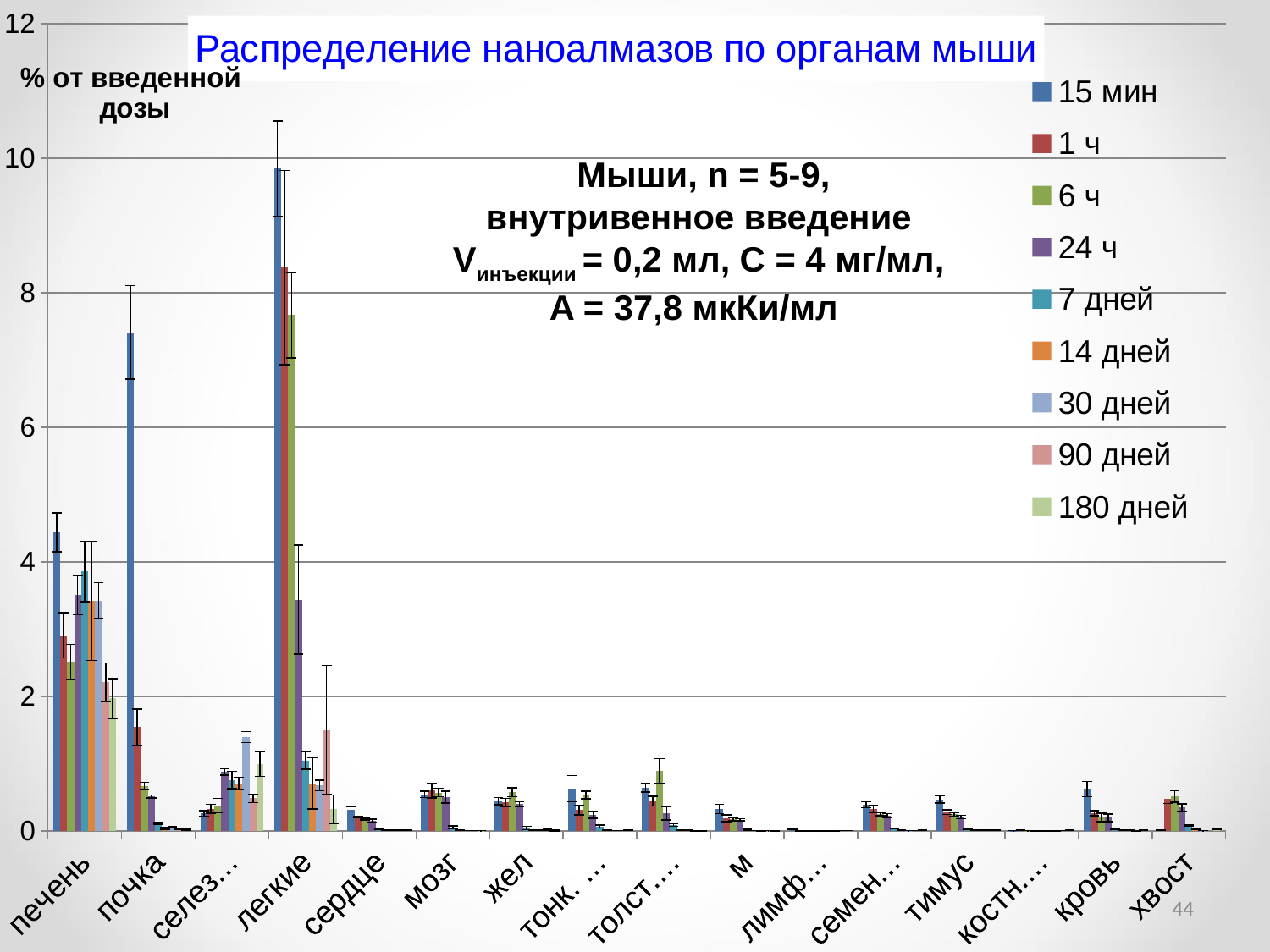
How many organ categories are shown along the x axis? 16 Which organ has the tallest bar in the chart? легкие What kind of chart is shown on the slide? bar chart Is the value for сердце at 15 мин greater or less than 2? less Is the value for печень at 15 мин greater or less than 6? less What is the label of the vertical axis? % от введенной дозы How many series does the legend list? 9 Is the value for почка at 15 мин greater or less than 6? greater Which is larger at 15 мин: the value for печень or the value for почка? почка Which series has the tallest bar for легкие? 15 мин What is the title of the chart? Распределение наноалмазов по органам мыши